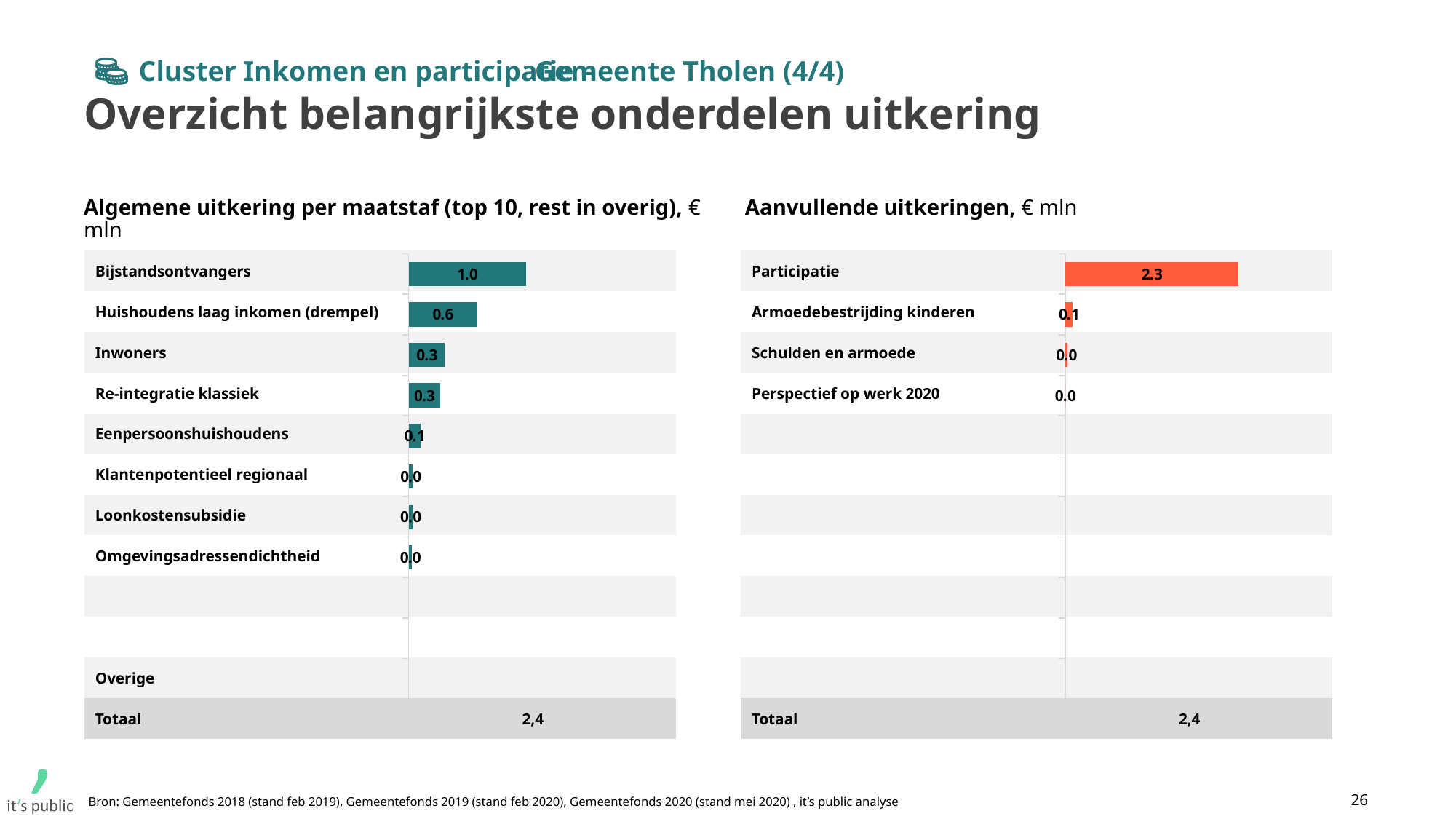
What is the Totaal shown at the bottom of the right chart (Aanvullende uitkeringen)? 2,4 In the right chart (Aanvullende uitkeringen), how many categories are listed above the Totaal row? 4 In the left chart (Algemene uitkering per maatstaf), which is larger: Huishoudens laag inkomen (drempel) or Inwoners? Huishoudens laag inkomen (drempel) In the right chart (Aanvullende uitkeringen), what is the value for Participatie? 2.3 In the left chart (Algemene uitkering per maatstaf), which category has the highest value? Bijstandsontvangers In the right chart (Aanvullende uitkeringen), which category has the highest value? Participatie In the left chart (Algemene uitkering per maatstaf), what is the difference between Bijstandsontvangers and Huishoudens laag inkomen (drempel)? 0.4 In the left chart (Algemene uitkering per maatstaf), what is the value for Bijstandsontvangers? 1.0 In the right chart (Aanvullende uitkeringen), what is the value for Armoedebestrijding kinderen? 0.1 In the left chart (Algemene uitkering per maatstaf), what is the value for Huishoudens laag inkomen (drempel)? 0.6 In the right chart (Aanvullende uitkeringen), what is the difference between Participatie and Armoedebestrijding kinderen? 2.2 What kind of chart is the left chart (Algemene uitkering per maatstaf)? Bar chart